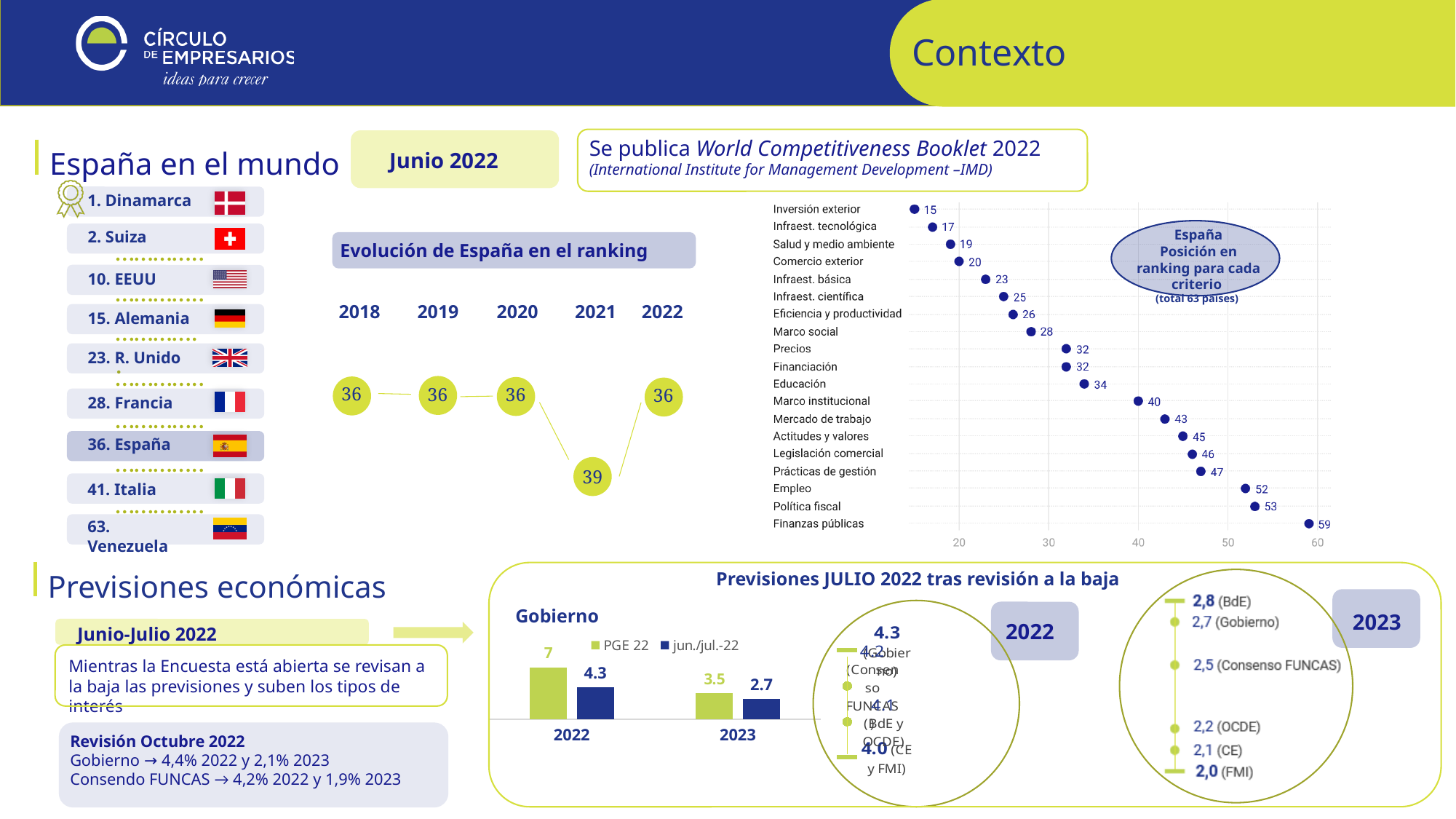
In the 'España Posición en ranking para cada criterio' chart, what is the ranking position for Finanzas públicas? 59 In the 'España Posición en ranking para cada criterio' chart, what is the ranking position for Educación? 34 In the 'Evolución de España en el ranking' chart, what is the difference between the 2021 value and the 2022 value? 3 In the 'Gobierno' bar chart, what is the PGE 22 value for 2022? 7 In the 'Evolución de España en el ranking' chart, what was Spain's ranking position in 2018? 36 In the 'Gobierno' bar chart, how many series does the legend list? 2 In the 'España Posición en ranking para cada criterio' chart, what is the difference between the positions for Política fiscal and Empleo? 1 In the 'España Posición en ranking para cada criterio' chart, which criterion has the highest ranking position? Finanzas públicas In the 'Evolución de España en el ranking' chart, how many years are plotted? 5 In the 'España Posición en ranking para cada criterio' chart, which criterion has the lowest (best) ranking position? Inversión exterior In the 'Evolución de España en el ranking' chart, what was Spain's ranking position in 2021? 39 In the 'Gobierno' bar chart, what is the jun./jul.-22 value for 2023? 2.7